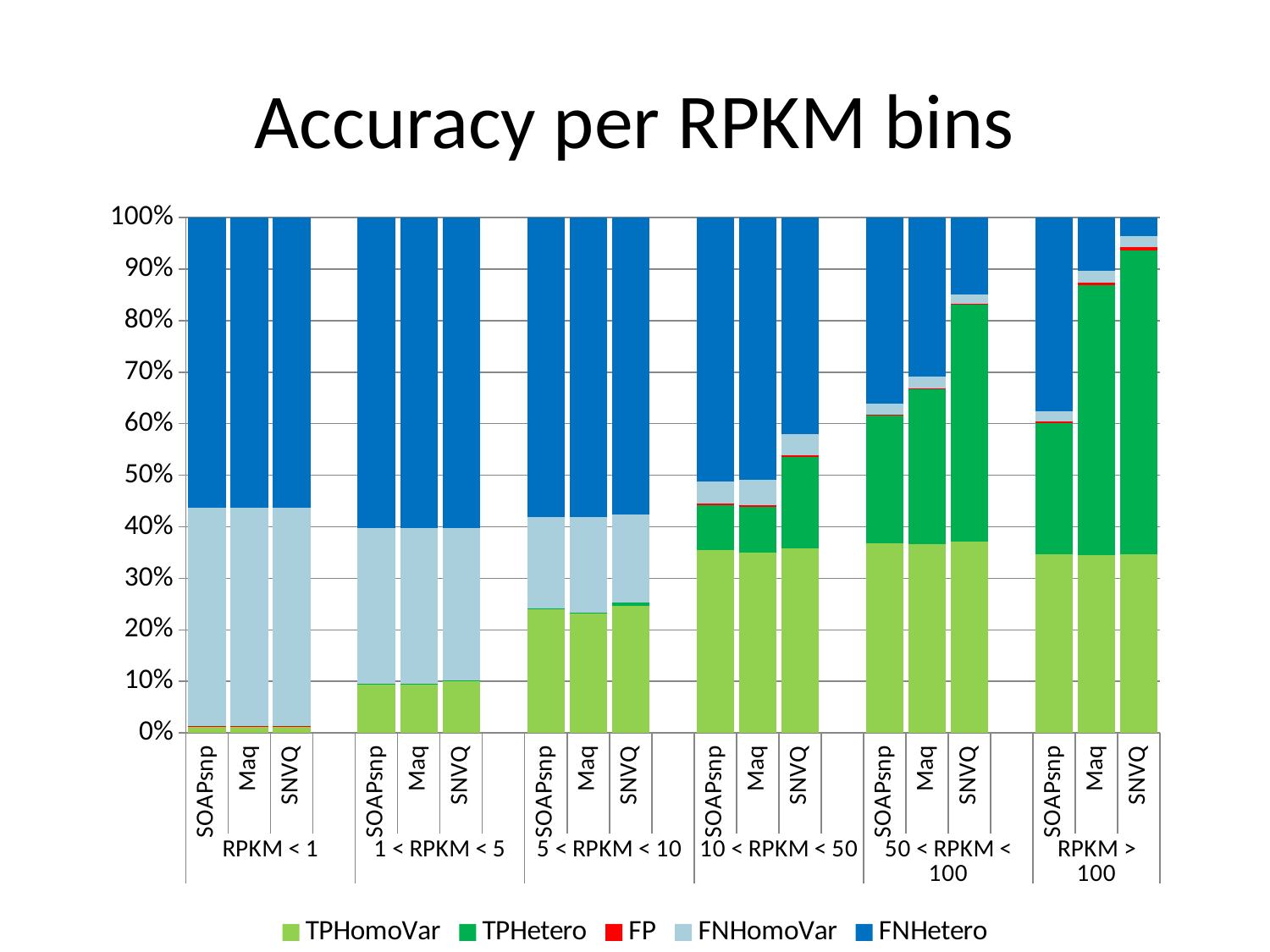
How many bars are plotted in total on the chart? 18 What is the title of the chart? Accuracy per RPKM bins How many RPKM bins are shown along the x axis? 6 How many series does the legend list? 5 In the 50 < RPKM < 100 bin, which tool has the largest TPHetero segment? SNVQ What kind of chart is shown on the slide? Stacked bar chart Does the FNHetero share for SNVQ rise or fall as the RPKM bins increase from left to right? Fall Which colour represents the FP series in the legend? Red Is the TPHomoVar share for SNVQ in the 10 < RPKM < 50 bin greater or less than 30%? greater In the RPKM > 100 bin, which tool has the smallest FNHetero segment? SNVQ Is the combined TPHomoVar and TPHetero share for SNVQ in the RPKM > 100 bin greater or less than 90%? greater Is the TPHomoVar share for SOAPsnp in the 5 < RPKM < 10 bin greater or less than 20%? greater